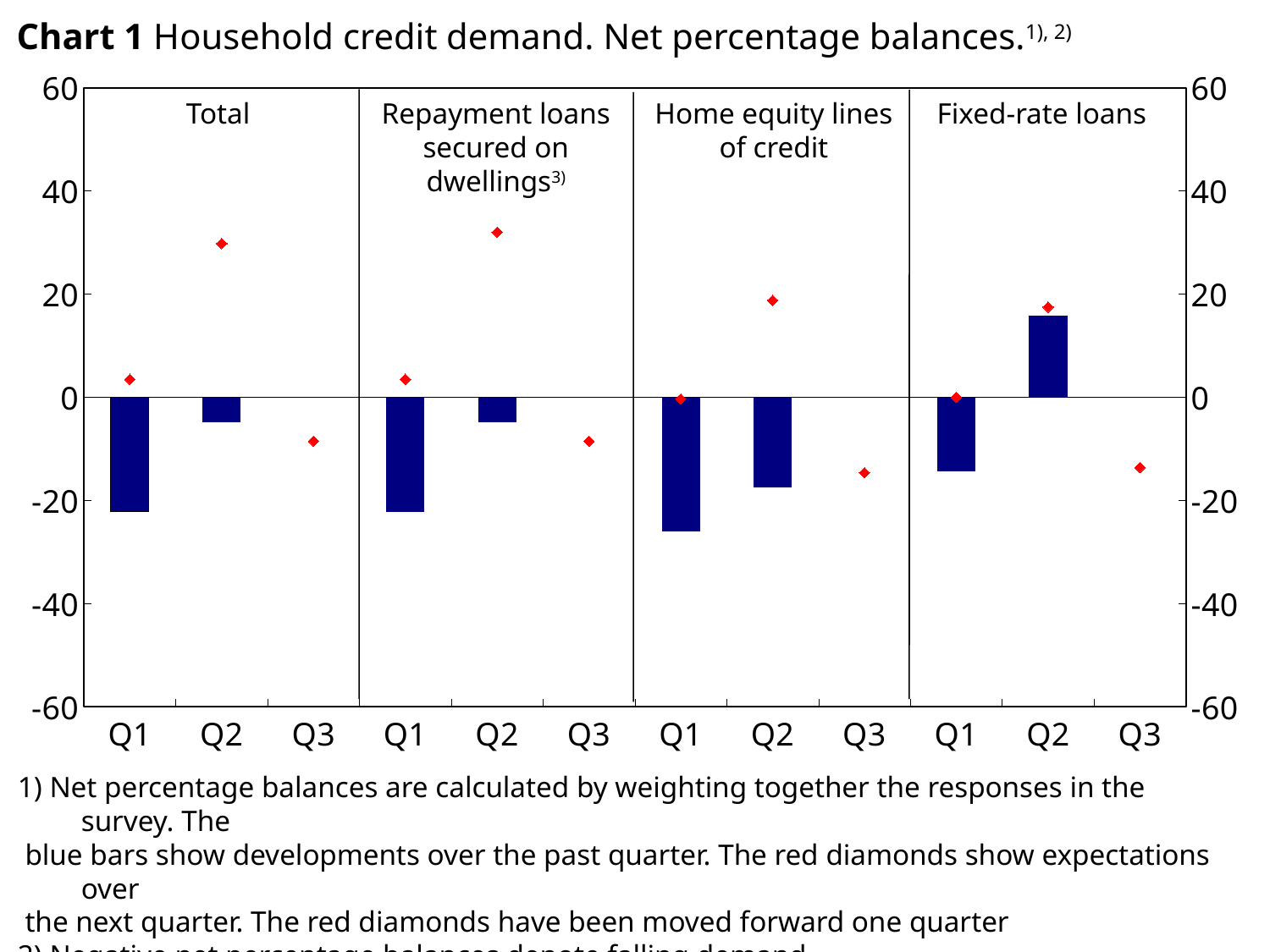
What kind of chart is Chart 1? combination bar and line chart (bars with red diamond markers) How many quarters are shown on the x axis within each panel of Chart 1? 3 In the Total panel, is the Q1 bar value greater or less than -20? less In the Fixed-rate loans panel, is the Q2 bar value greater or less than 0? greater In the Home equity lines of credit panel, is the Q2 bar value greater or less than -10? less Which panel has the lowest Q1 bar value? Home equity lines of credit In the Fixed-rate loans panel, does the bar value rise or fall from Q1 to Q2? rise Which Q1 bar is lower: Home equity lines of credit or Fixed-rate loans? Home equity lines of credit Which panel has the highest Q2 bar value? Fixed-rate loans According to the footnote, what do the red diamonds in Chart 1 show? Expectations over the next quarter How many loan categories (panels) are shown in Chart 1? 4